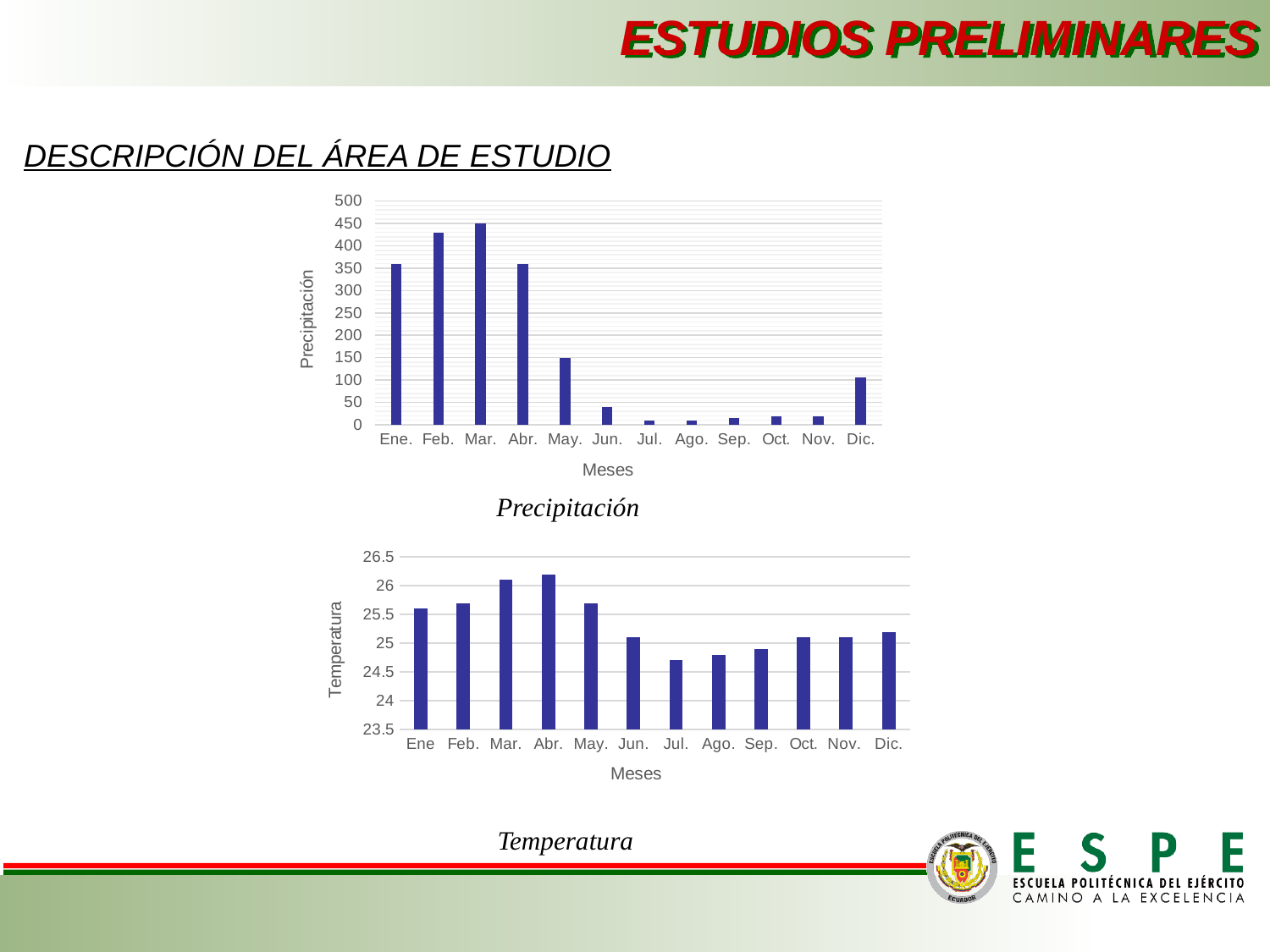
In the Temperatura chart, which is larger, the value for Abr. or the value for Ago.? Abr. In the Precipitación chart, do the values rise or fall from Mar. to Jul.? fall How many months are shown on the x axis of the Temperatura chart? 12 In the Temperatura chart, is the value for Jul. greater or less than 25? less What kind of chart is the Precipitación chart? bar chart In the Precipitación chart, is the value for Feb. greater or less than 400? greater In the Precipitación chart, which is larger, the value for Ene. or the value for May.? Ene. In the Precipitación chart, which month has the highest precipitation? Mar. What is the y-axis label of the Temperatura chart? Temperatura In the Precipitación chart, is the value for Dic. greater or less than 150? less